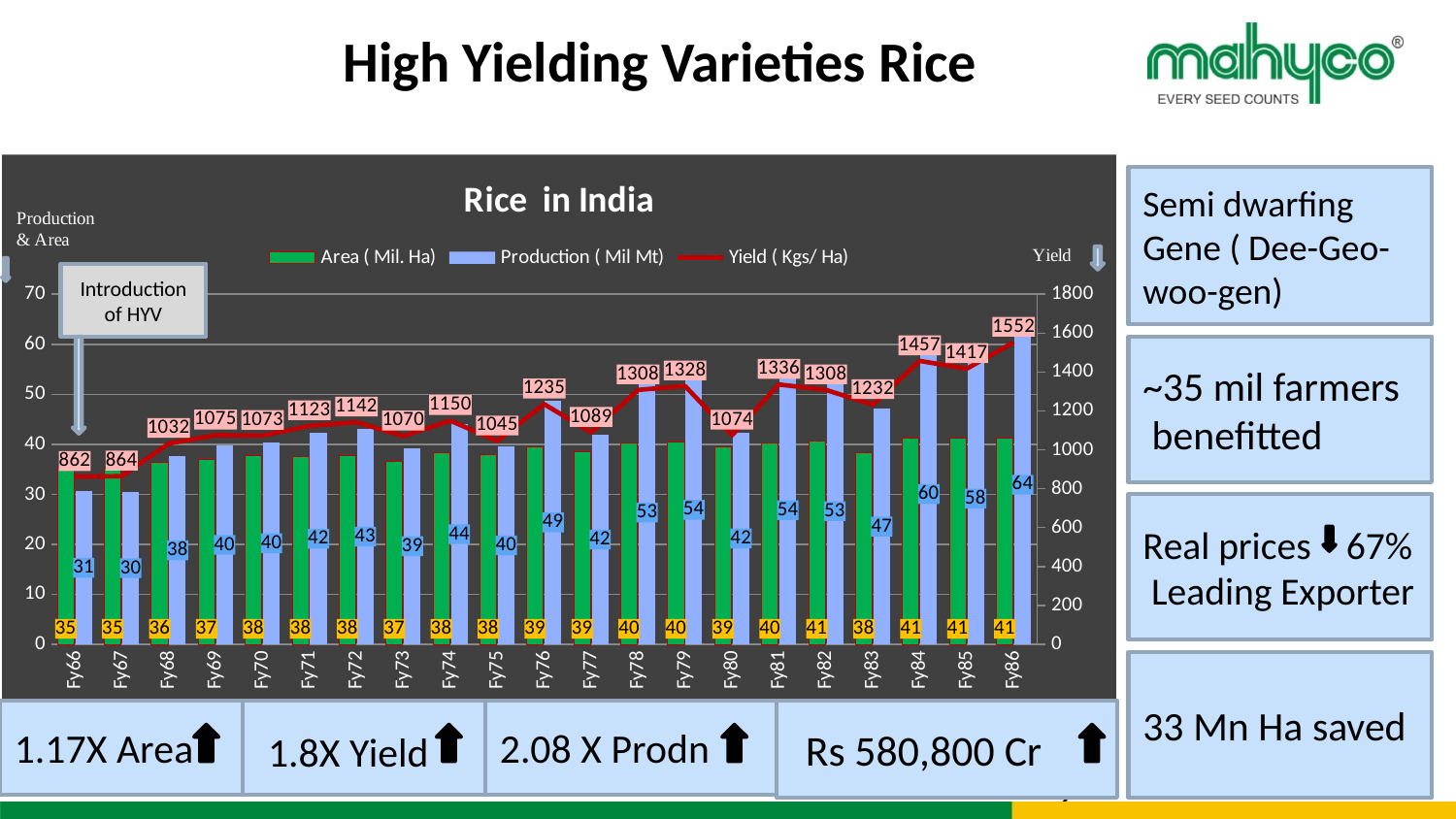
What is the Production (Mil Mt) value for Fy86? 64 Does the Yield (Kgs/Ha) line generally rise or fall from Fy66 to Fy86? Rise Which fiscal year has the highest Production (Mil Mt)? Fy86 What is the Area (Mil. Ha) value for Fy80? 39 How many series does the legend of the 'Rice in India' chart list? 3 Which series in the 'Rice in India' chart is drawn as a red line? Yield ( Kgs/ Ha) What kind of chart is the 'Rice in India' chart? A bar chart combined with a line What is the Yield (Kgs/Ha) value for Fy66? 862 How many fiscal years are shown on the x axis of the 'Rice in India' chart? 21 Which fiscal year has the lowest Production (Mil Mt)? Fy67 By how much did Yield (Kgs/Ha) increase from Fy66 to Fy86? 690 Which year has the higher Production (Mil Mt), Fy84 or Fy85? Fy84